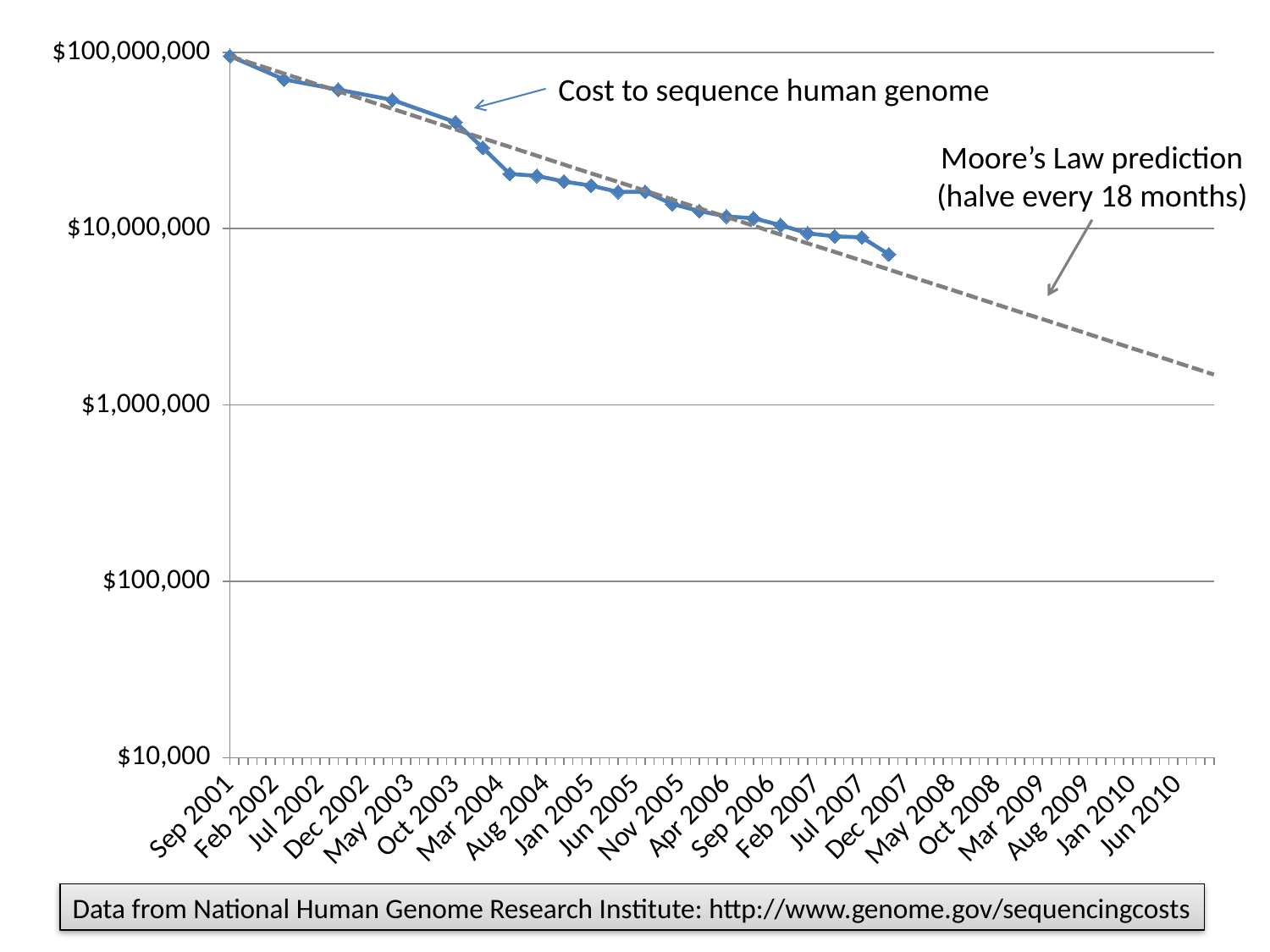
How many lines are plotted on the chart? 2 Is the cost to sequence a human genome in Mar 2004 greater or less than $10,000,000? greater Which is larger: the cost to sequence a human genome in Sep 2001 or in Dec 2007? Sep 2001 Is the cost to sequence a human genome in Sep 2001 greater or less than $10,000,000? greater Does the cost to sequence a human genome rise or fall over time along the x axis? fall Is the cost to sequence a human genome at the last plotted point (Dec 2007) greater or less than $10,000,000? less What kind of chart is shown on the slide? line chart What does the dashed line on the chart represent? Moore's Law prediction (halve every 18 months) Which date has the highest cost to sequence a human genome? Sep 2001 What is the lowest value shown on the y axis? $10,000